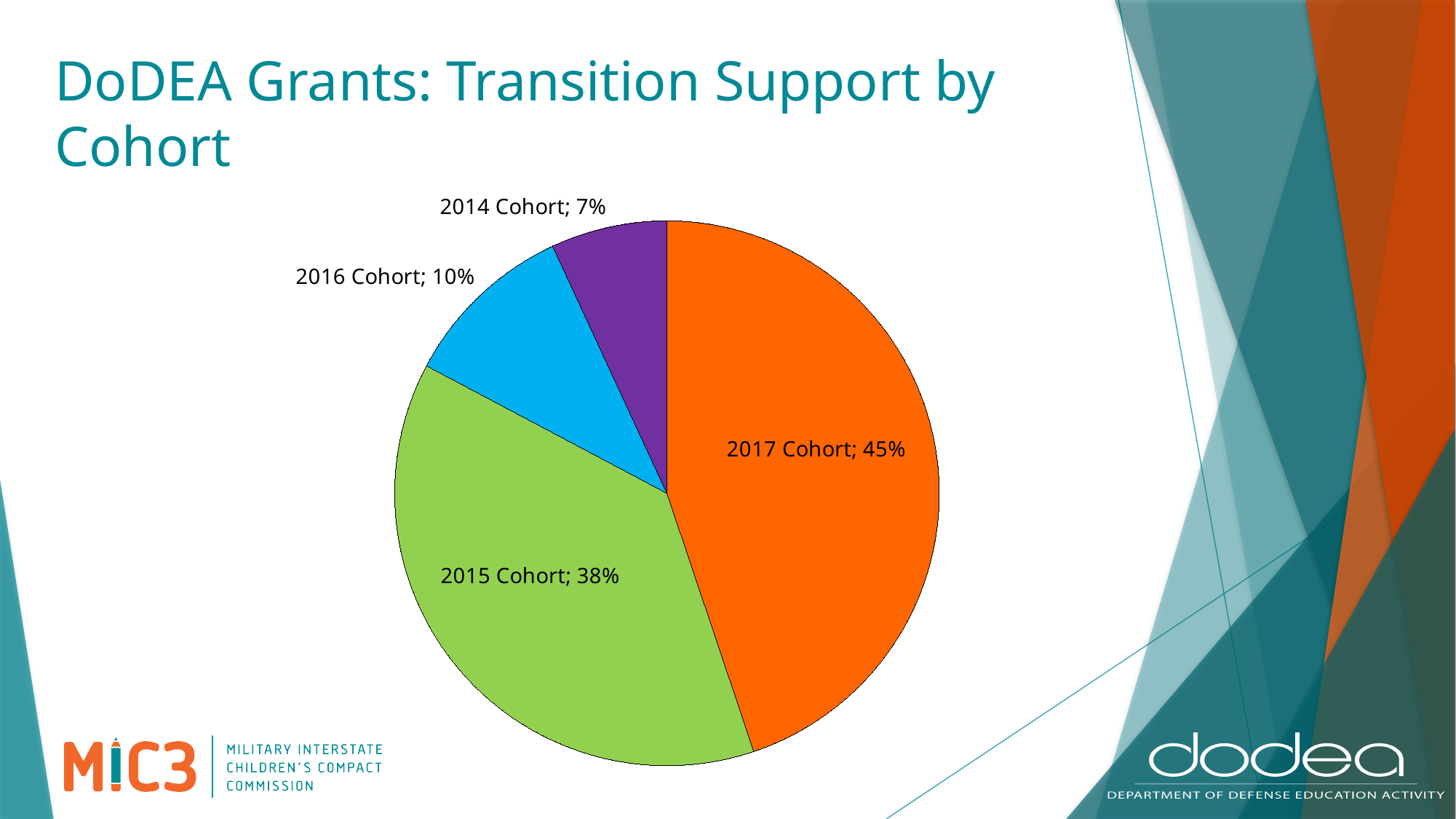
What share of the pie does the 2017 Cohort represent? 45% What kind of chart is shown on the slide? Pie chart What is the value shown for the 2016 Cohort? 10% How many cohorts are shown in the pie chart? 4 What is the value shown for the 2014 Cohort? 7% Which is larger, the 2015 Cohort slice or the 2016 Cohort slice? 2015 Cohort What colour is the slice for the 2014 Cohort? Purple Which cohort has the smallest slice of the pie? 2014 Cohort What share of the pie does the 2015 Cohort represent? 38% What is the difference in percentage points between the 2017 Cohort and the 2015 Cohort? 7 What is the difference in percentage points between the 2016 Cohort and the 2014 Cohort? 3 Which cohort has the largest slice of the pie? 2017 Cohort